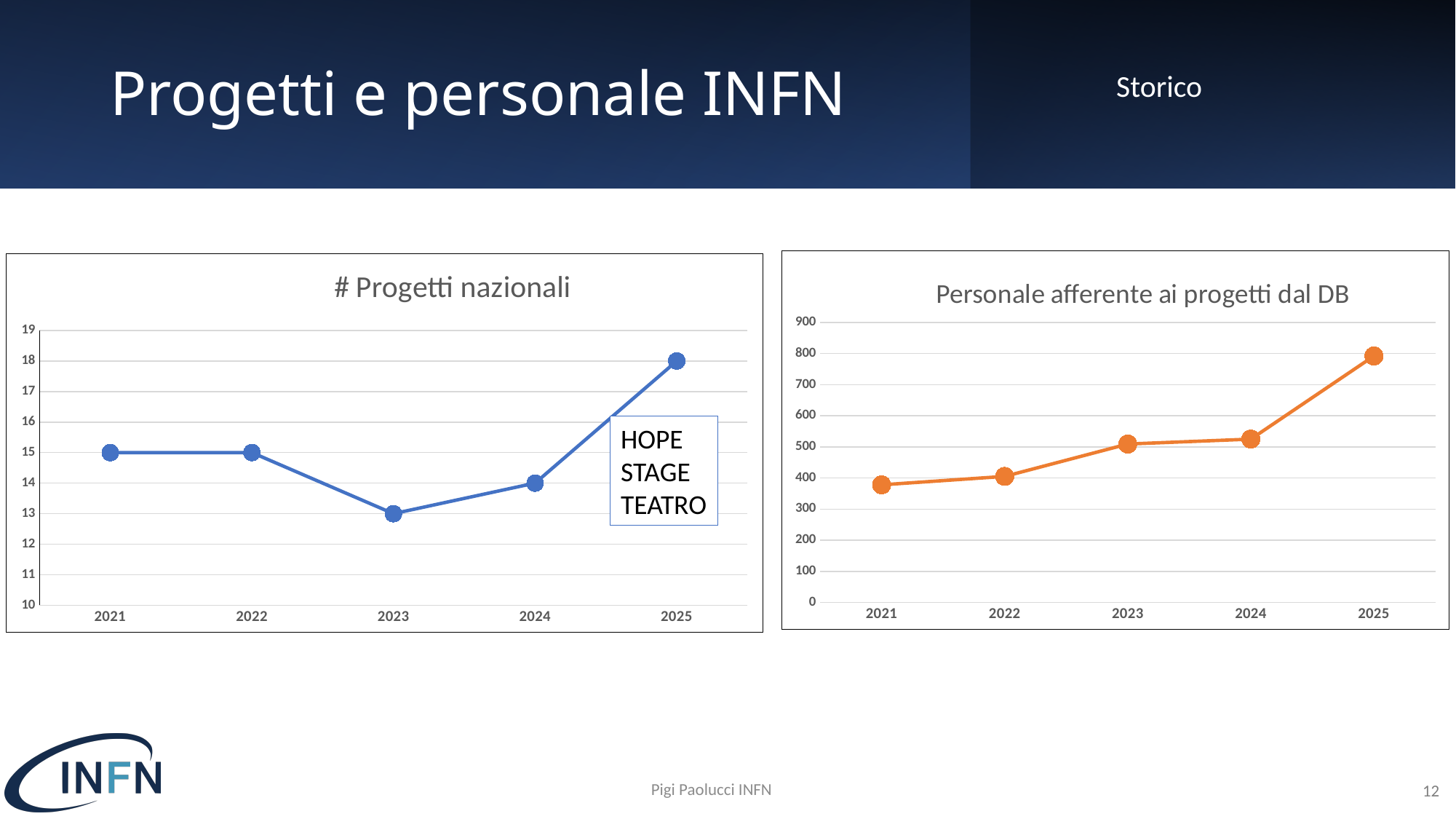
In the '# Progetti nazionali' chart, which year has the highest value? 2025 In the '# Progetti nazionali' chart, what is the value for 2025? 18 In the '# Progetti nazionali' chart, how many data points are plotted? 5 In the '# Progetti nazionali' chart, what is the difference between the values for 2025 and 2024? 4 In the '# Progetti nazionali' chart, which year has the lowest value? 2023 What kind of chart is 'Personale afferente ai progetti dal DB'? line chart In the '# Progetti nazionali' chart, what is the value for 2023? 13 In the 'Personale afferente ai progetti dal DB' chart, is the value for 2021 greater or less than 400? less In the 'Personale afferente ai progetti dal DB' chart, which year has the highest value? 2025 In the 'Personale afferente ai progetti dal DB' chart, do the values rise or fall from 2021 to 2025? rise What colour is the line in the 'Personale afferente ai progetti dal DB' chart? orange In the 'Personale afferente ai progetti dal DB' chart, is the value for 2025 greater or less than 700? greater